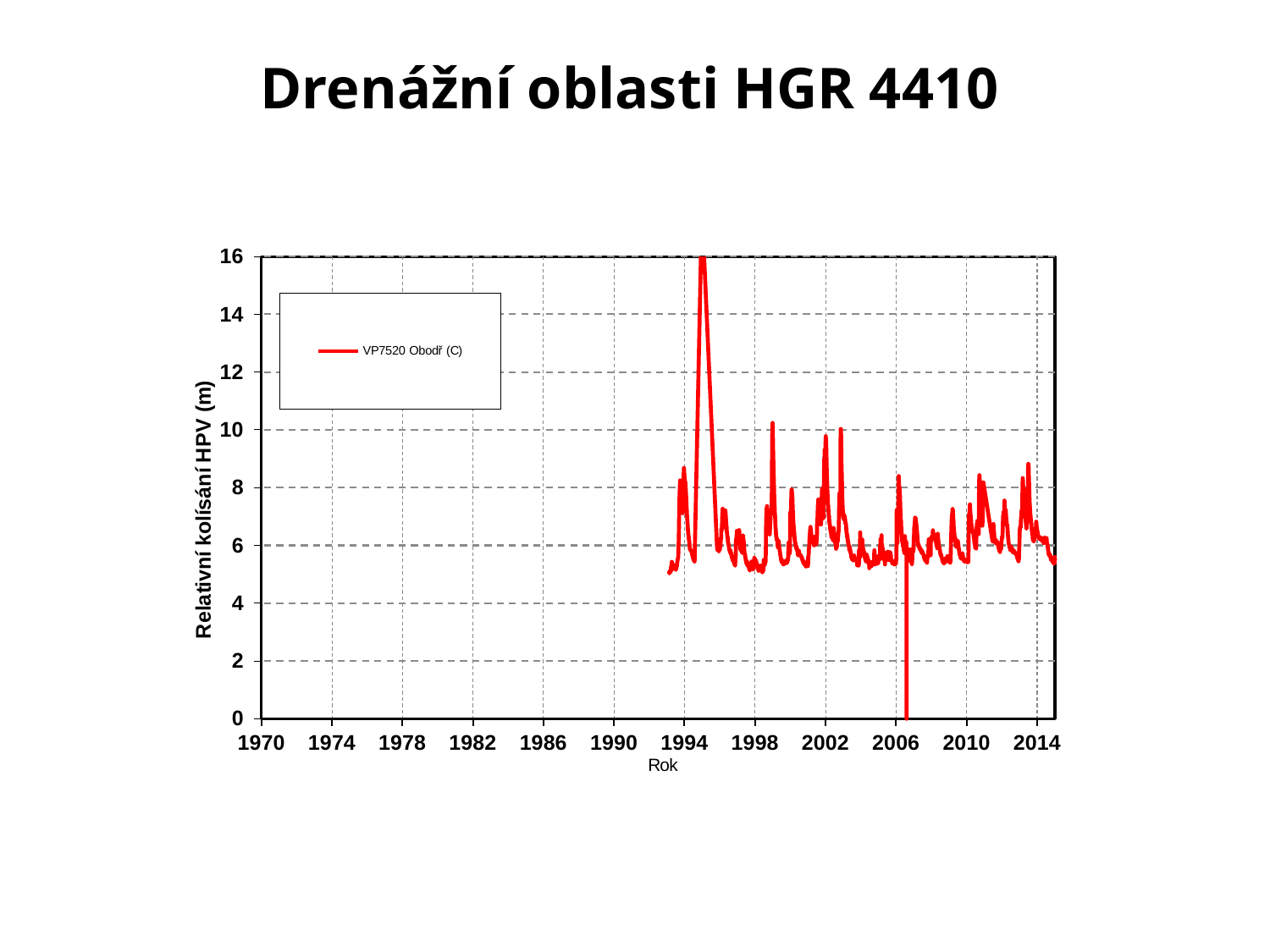
What is the maximum value shown on the vertical axis? 16 Is the value of the VP7520 Obodř (C) series at the end of the record in 2014 greater or less than 8? less How many year labels are shown on the horizontal axis? 12 Is the value of the VP7520 Obodř (C) series at the start of the record in 1993 greater or less than 6? less Is the peak of the VP7520 Obodř (C) series around 1995 higher or lower than the peak around 1999? higher How many series does the legend list? 1 Is the lowest value of the VP7520 Obodř (C) series, the dip around 2006, greater or less than 2? less What is the title of the chart on the slide? Drenážní oblasti HGR 4410 What is the name of the series shown in the legend? VP7520 Obodř (C) What kind of chart is shown on the slide? line chart Around which year does the VP7520 Obodř (C) series reach its highest value? 1995